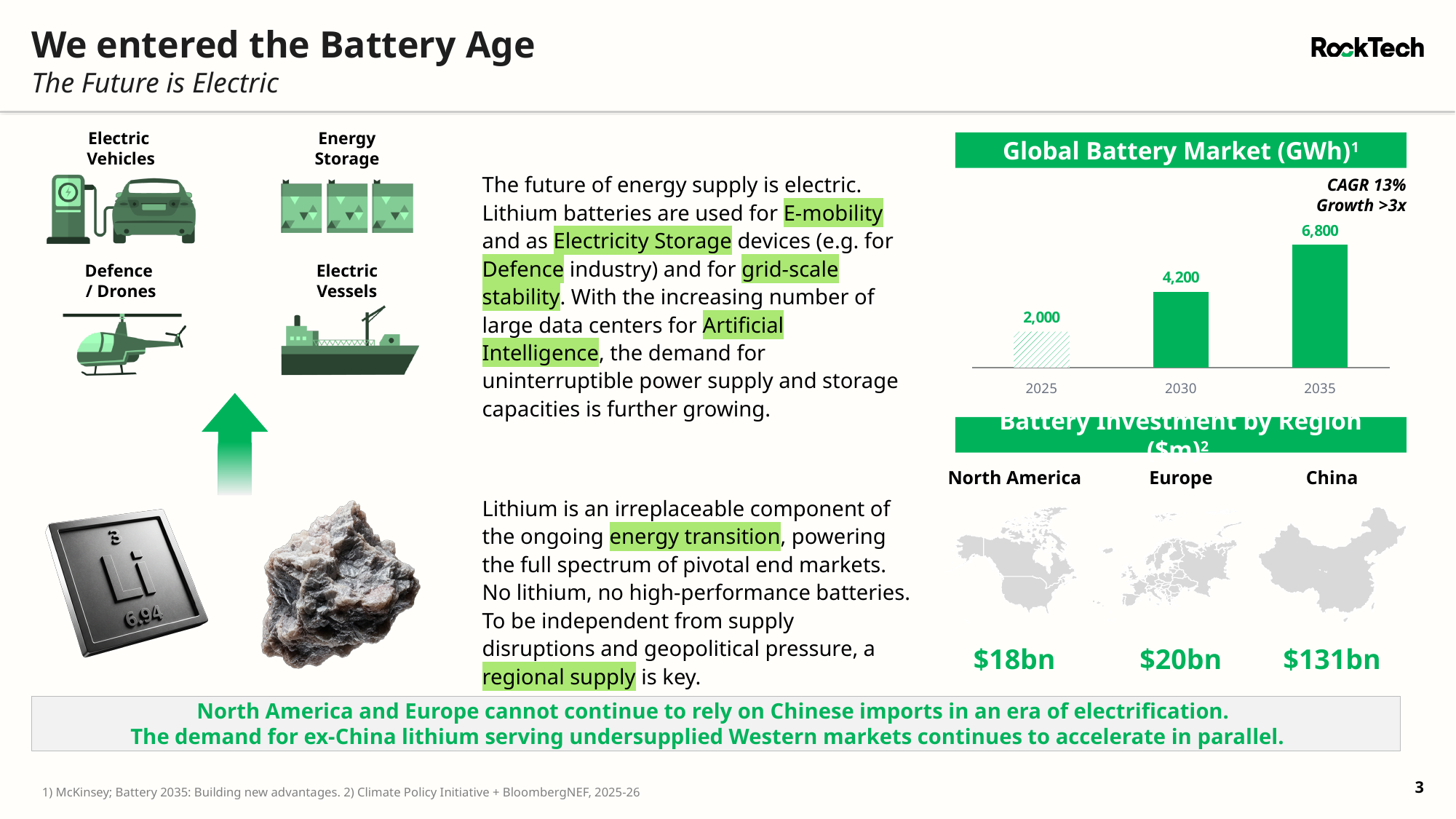
In the Global Battery Market (GWh) chart, which year has the highest value? 2035 How many years are shown in the Global Battery Market (GWh) chart? 3 In the Global Battery Market (GWh) chart, do the values rise or fall from 2025 to 2035? Rise What CAGR is annotated on the Global Battery Market (GWh) chart? 13% In the Global Battery Market (GWh) chart, what is the difference between the 2030 and 2025 values? 2,200 In the Global Battery Market (GWh) chart, what is the value for 2025? 2,000 In the Global Battery Market (GWh) chart, which is larger, the value for 2025 or the value for 2030? 2030 In the Global Battery Market (GWh) chart, what is the value for 2030? 4,200 In the Global Battery Market (GWh) chart, what is the value for 2035? 6,800 In the Global Battery Market (GWh) chart, what is the difference between the 2035 and 2030 values? 2,600 In the Global Battery Market (GWh) chart, which year has the lowest value? 2025 What type of chart is the Global Battery Market (GWh) chart? Bar chart